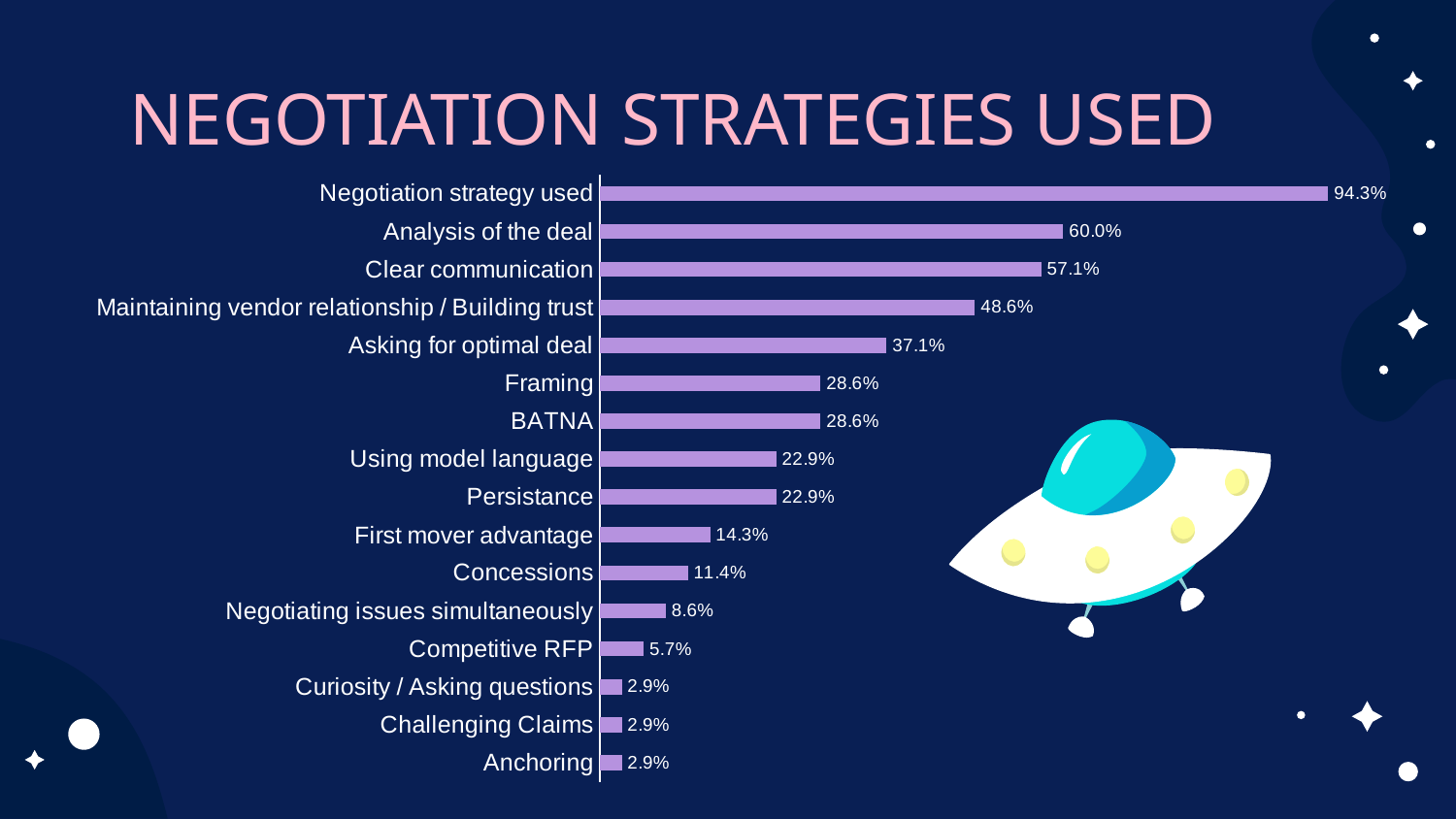
What kind of chart is shown on the slide? Bar chart What is the difference between the values for Analysis of the deal and Clear communication? 2.9% What is the value for Competitive RFP? 5.7% What is the value for Maintaining vendor relationship / Building trust? 48.6% Which is larger, the value for First mover advantage or the value for Negotiating issues simultaneously? First mover advantage What is the difference between the values for Negotiation strategy used and Analysis of the deal? 34.3% Which is larger, the value for Asking for optimal deal or the value for Framing? Asking for optimal deal What is the value for Analysis of the deal? 60.0% Which category has the highest value? Negotiation strategy used What is the value for Concessions? 11.4% How many categories are shown in the chart? 16 What is the title of the slide containing the chart? NEGOTIATION STRATEGIES USED